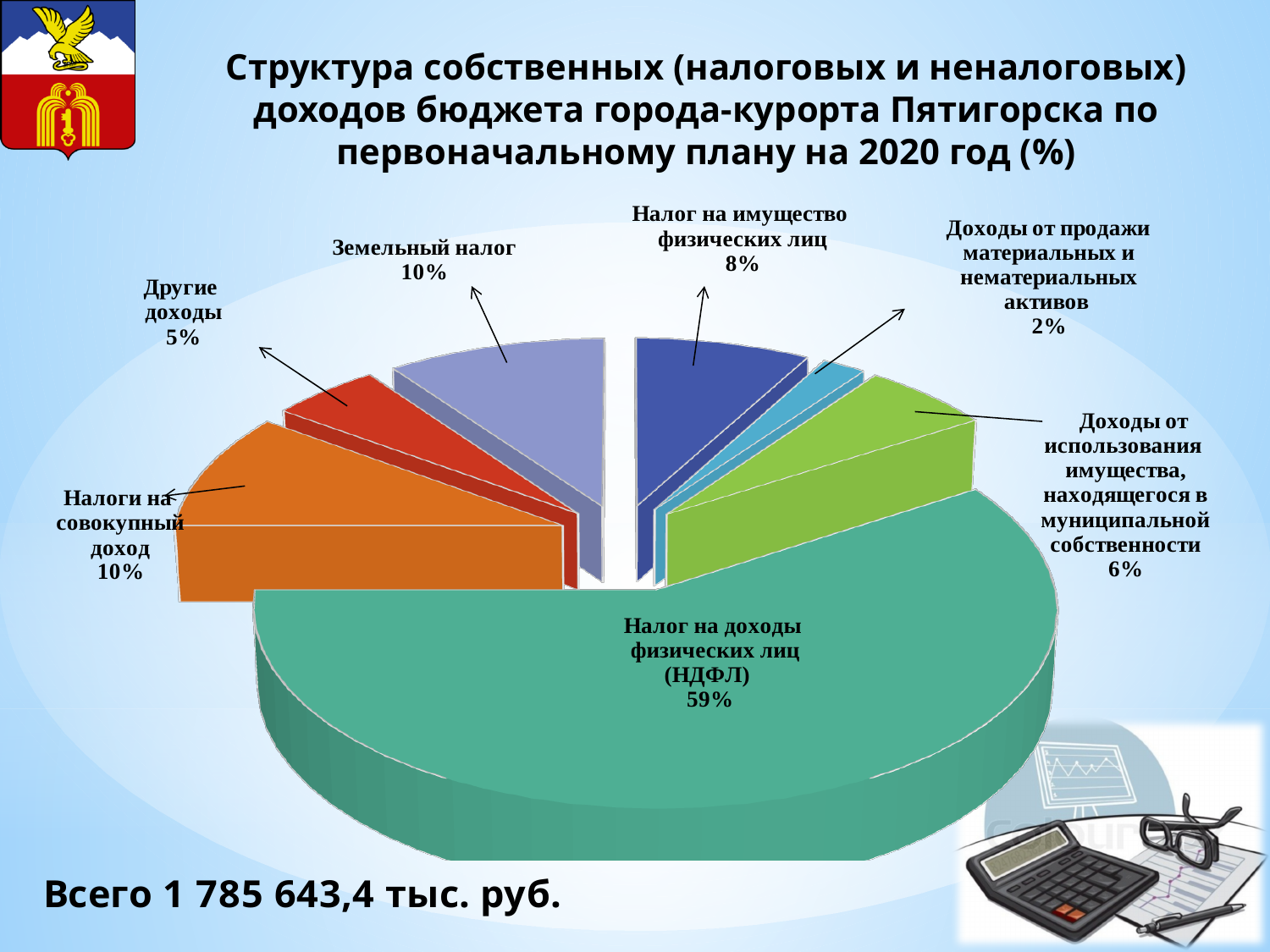
What colour is the slice for "Налог на доходы физических лиц (НДФЛ)"? Teal (green) What kind of chart is shown on the slide? Pie chart What share of the pie does "Налог на доходы физических лиц (НДФЛ)" have? 59% Which category has the smallest share of the pie? Доходы от продажи материальных и нематериальных активов What total amount is stated at the bottom of the slide? 1 785 643,4 тыс. руб. Which category has the largest share of the pie? Налог на доходы физических лиц (НДФЛ) How many slices does the pie chart have? 7 What is the value shown for "Доходы от использования имущества, находящегося в муниципальной собственности"? 6% Which is larger: the share of "Налоги на совокупный доход" or the share of "Налог на имущество физических лиц"? Налоги на совокупный доход What is the value shown for "Земельный налог"? 10% What is the value shown for "Доходы от продажи материальных и нематериальных активов"? 2% What is the difference between the shares of "Налог на имущество физических лиц" and "Другие доходы"? 3%